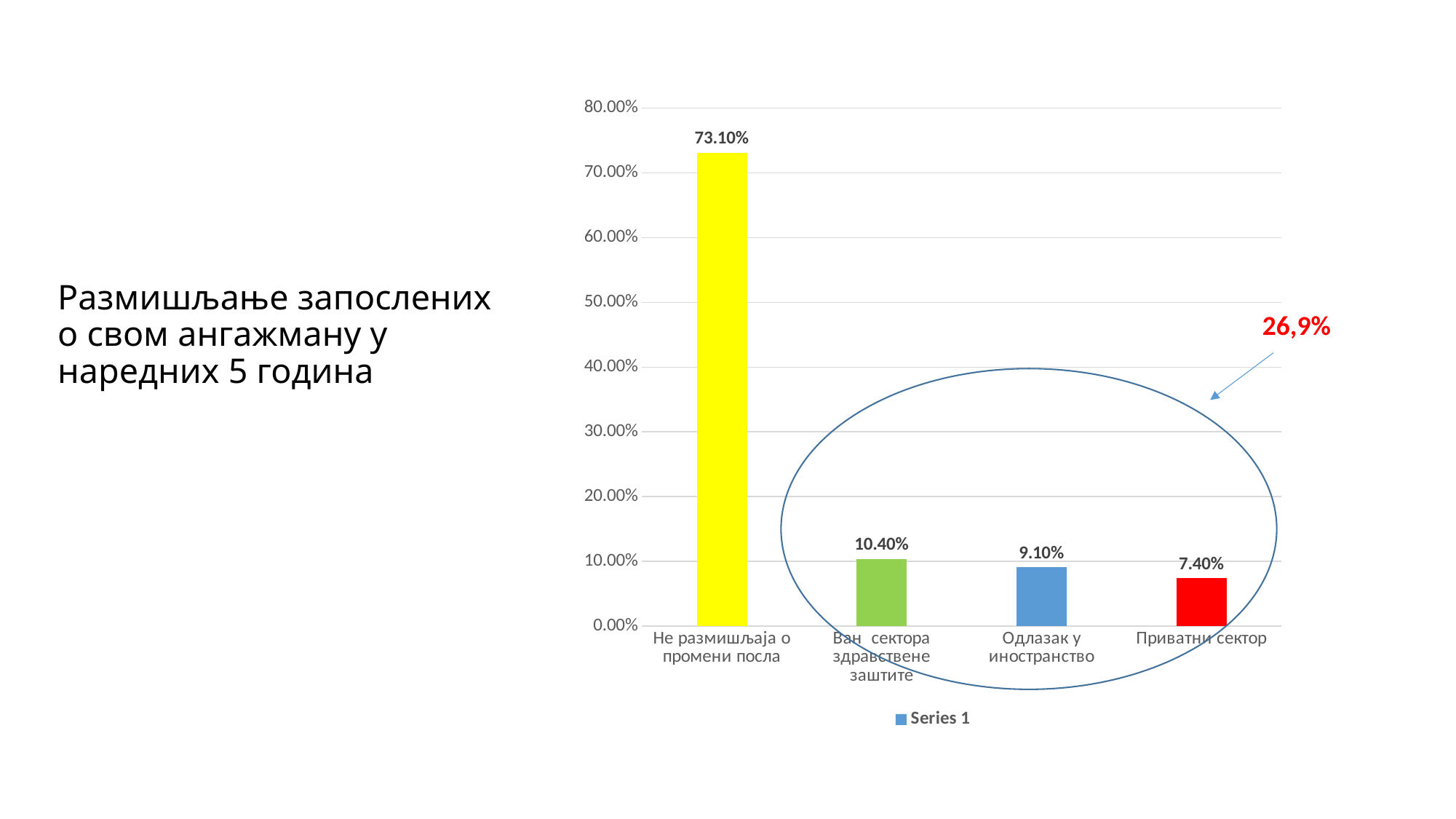
What is the value for "Не размишљаја о промени посла"? 73.10% What is the value for "Ван сектора здравствене заштите"? 10.40% How many categories are shown on the x axis? 4 Which category has the lowest value? Приватни сектор What is the difference between the values for "Не размишљаја о промени посла" and "Ван сектора здравствене заштите"? 62.70% What is the value for "Приватни сектор"? 7.40% What is the value for "Одлазак у иностранство"? 9.10% Which category has the highest value? Не размишљаја о промени посла What series name does the legend show? Series 1 Is the value for "Не размишљаја о промени посла" greater or less than 70.00%? greater What kind of chart is shown on the slide? bar chart Which is larger, the value for "Одлазак у иностранство" or for "Приватни сектор"? Одлазак у иностранство